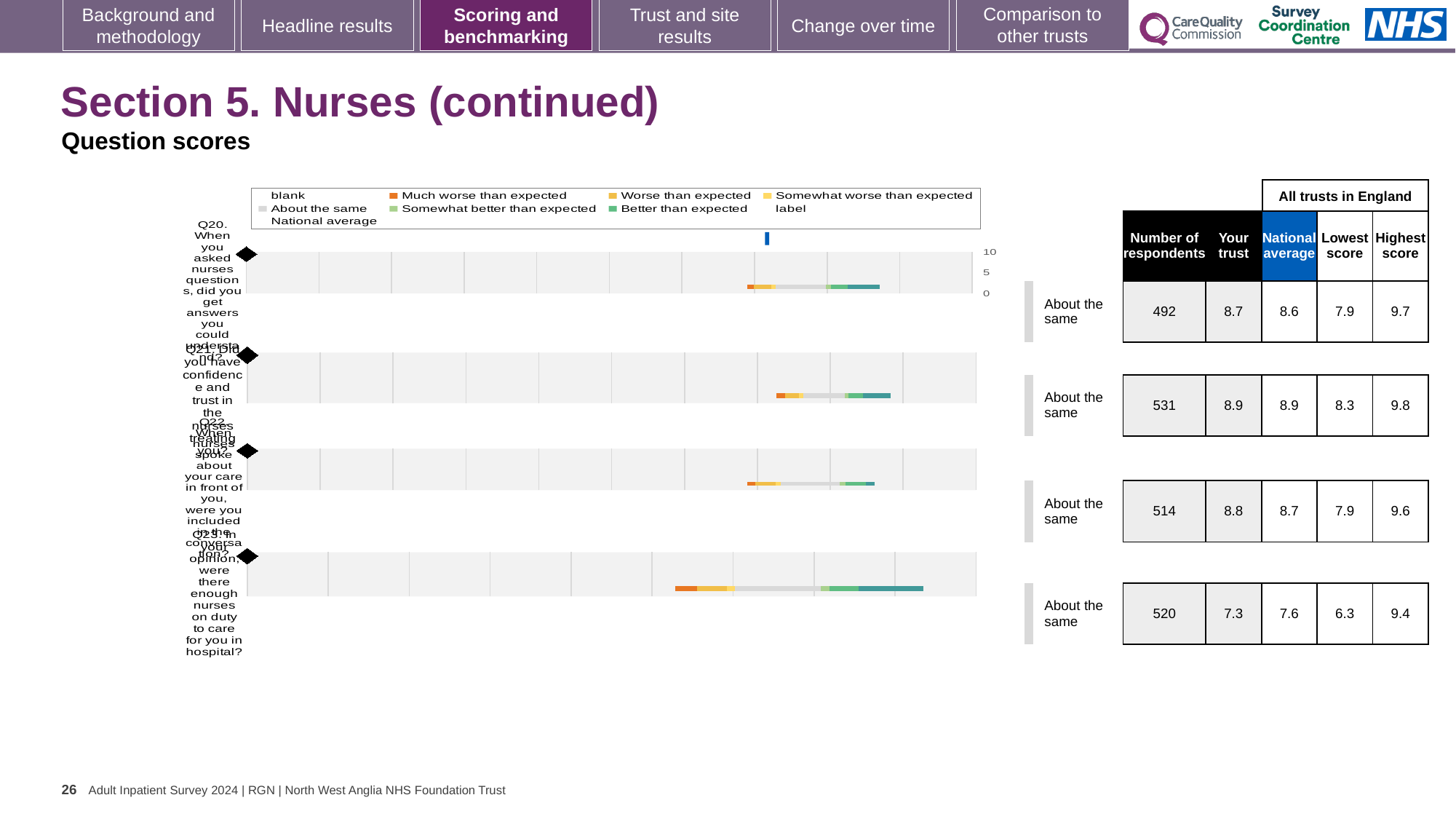
Which question has the highest 'Your trust' score on this slide? Q21 For Q23, what is the difference between the highest score and the lowest score among all trusts in England? 3.1 How many respondents answered Q21 (did you have confidence and trust in the nurses treating you)? 531 What is the highest score among all trusts in England for Q22 (when nurses spoke about your care in front of you, were you included in the conversation)? 9.6 What kind of chart is used to show the question scores on this slide? Bar chart What benchmark category is shown for Q23 (enough nurses on duty)? About the same What is the 'Your trust' score for Q20 (when you asked nurses questions, did you get answers you could understand)? 8.7 What is the national average score for Q23 (were there enough nurses on duty to care for you in hospital)? 7.6 For Q22, is the 'Your trust' score or the national average higher? Your trust Which question has the lowest 'Your trust' score on this slide? Q23 For Q20, what is the difference between the 'Your trust' score and the national average? 0.1 How many questions are plotted on this slide? 4